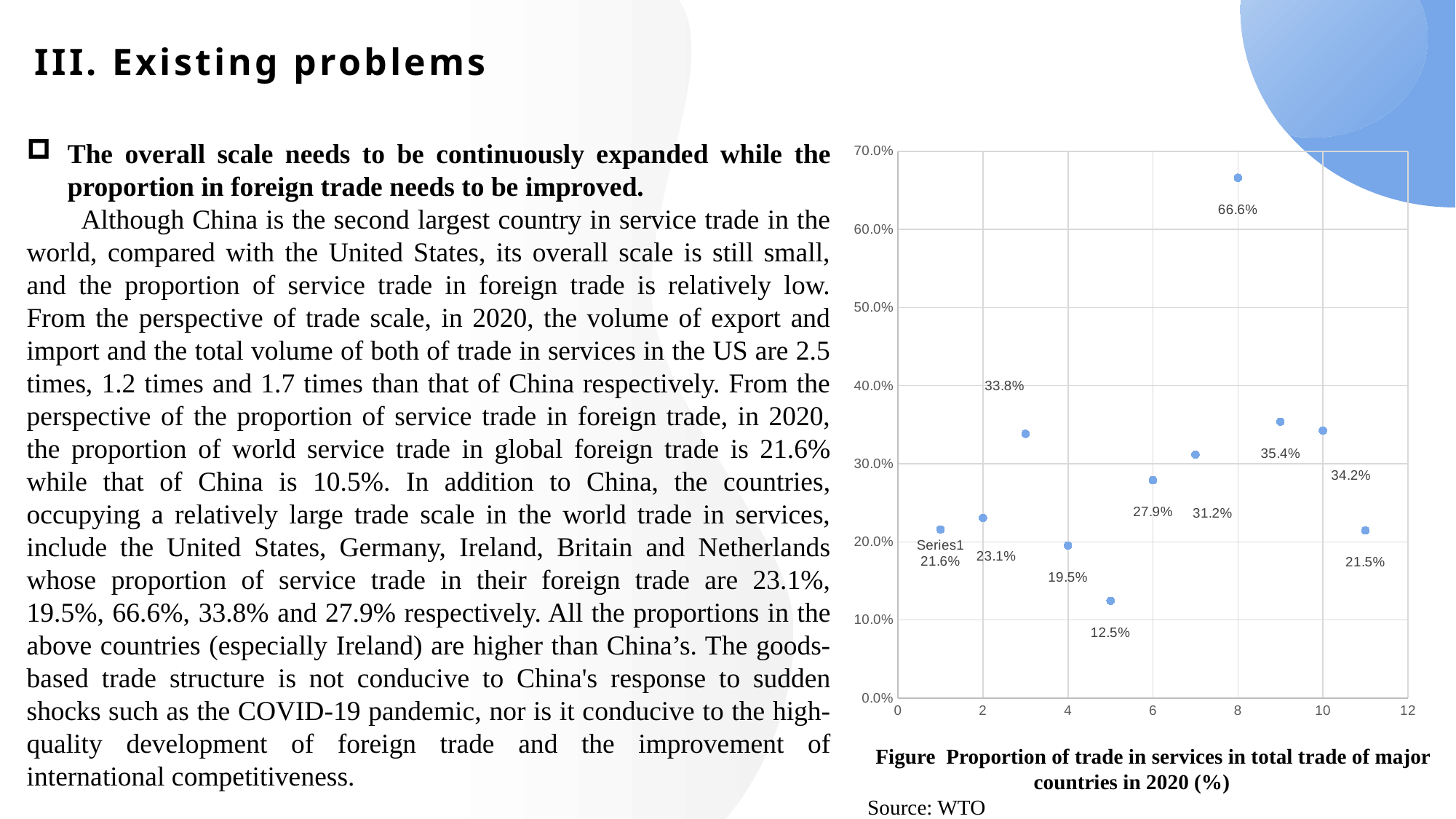
What is the title of the figure on the slide? Figure Proportion of trade in services in total trade of major countries in 2020 (%) Which is larger in the scatter chart, the value at x = 9 or the value at x = 10? x = 9 (35.4%) What kind of chart is shown on the slide? Scatter chart How many data points are plotted in the scatter chart? 11 What is the value of the point at x = 8 in the scatter chart? 66.6% Is the value at x = 7 in the scatter chart greater or less than 30.0%? greater What is the value of the point at x = 5 in the scatter chart? 12.5% Which x position has the highest value in the scatter chart? 8 What is the value of the point at x = 3 in the scatter chart? 33.8% Which x position has the lowest value in the scatter chart? 5 What is the value of the point at x = 11 in the scatter chart? 21.5% What is the difference between the values at x = 8 and x = 5 in the scatter chart? 54.1%